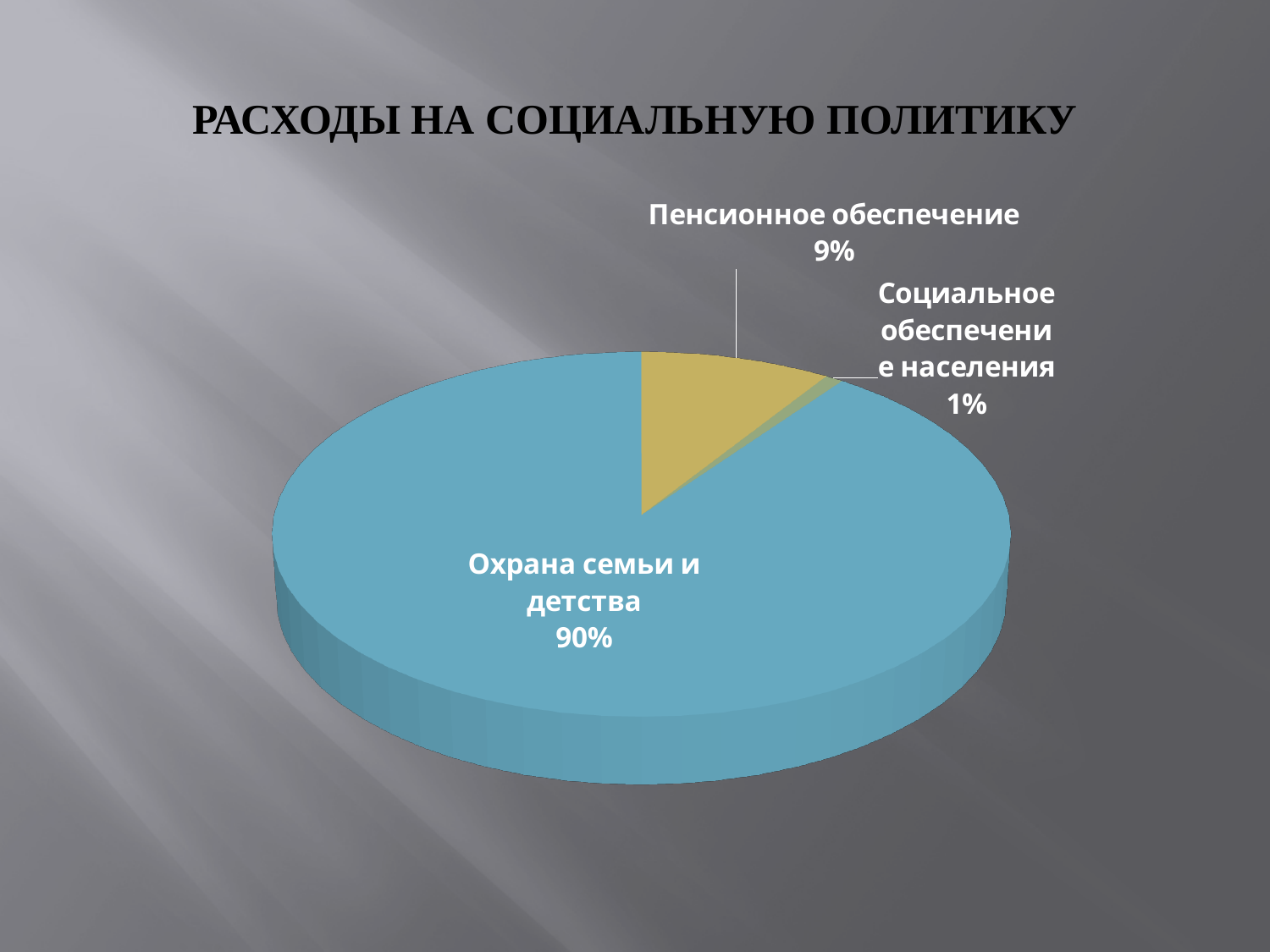
Which is larger: the share for Пенсионное обеспечение or the share for Социальное обеспечение населения? Пенсионное обеспечение What is the title of the chart on the slide? РАСХОДЫ НА СОЦИАЛЬНУЮ ПОЛИТИКУ How many categories are shown in the pie chart? 3 Which category has the smallest slice of the pie? Социальное обеспечение населения What is the difference in percentage points between Пенсионное обеспечение and Социальное обеспечение населения? 8 What is the difference in percentage points between Охрана семьи и детства and Пенсионное обеспечение? 81 What share of the pie does Охрана семьи и детства have? 90% What share of the pie does Социальное обеспечение населения have? 1% What share of the pie does Пенсионное обеспечение have? 9% What kind of chart is shown on the slide? Pie chart Which category has the largest slice of the pie? Охрана семьи и детства What colour is the slice for Пенсионное обеспечение? Yellow